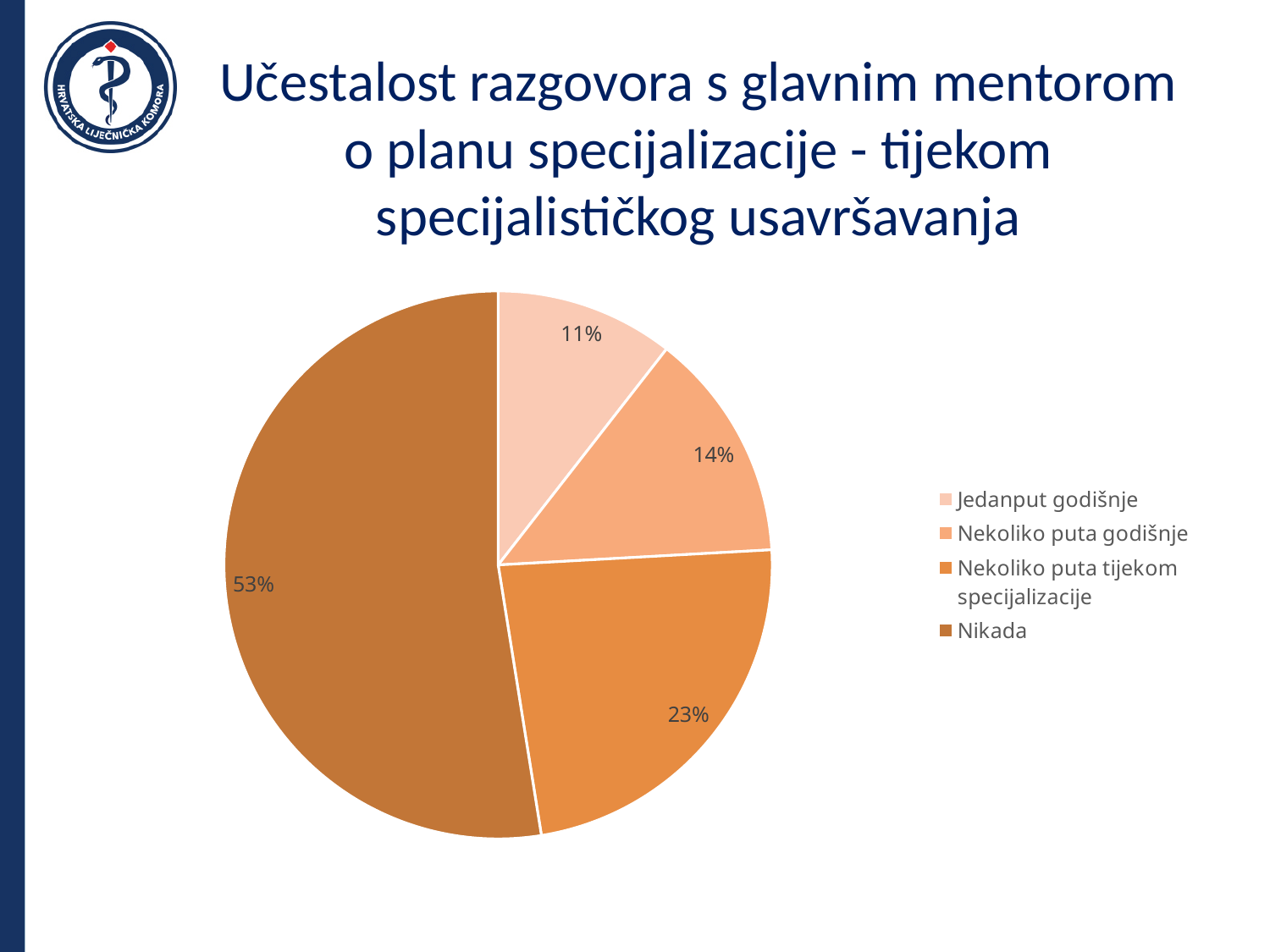
What share of the pie does "Nikada" represent? 53% What is the difference in percentage points between "Nikada" and "Nekoliko puta tijekom specijalizacije"? 30 Which category has the largest slice of the pie? Nikada What share of the pie does "Nekoliko puta tijekom specijalizacije" represent? 23% What is the difference in percentage points between "Nekoliko puta godišnje" and "Jedanput godišnje"? 3 What share of the pie does "Nekoliko puta godišnje" represent? 14% Which category has the smallest slice of the pie? Jedanput godišnje What kind of chart is shown on the slide? pie chart Which is larger: the slice for "Nekoliko puta tijekom specijalizacije" or the slice for "Nekoliko puta godišnje"? Nekoliko puta tijekom specijalizacije How many slices does the pie chart have? 4 How many entries does the legend list? 4